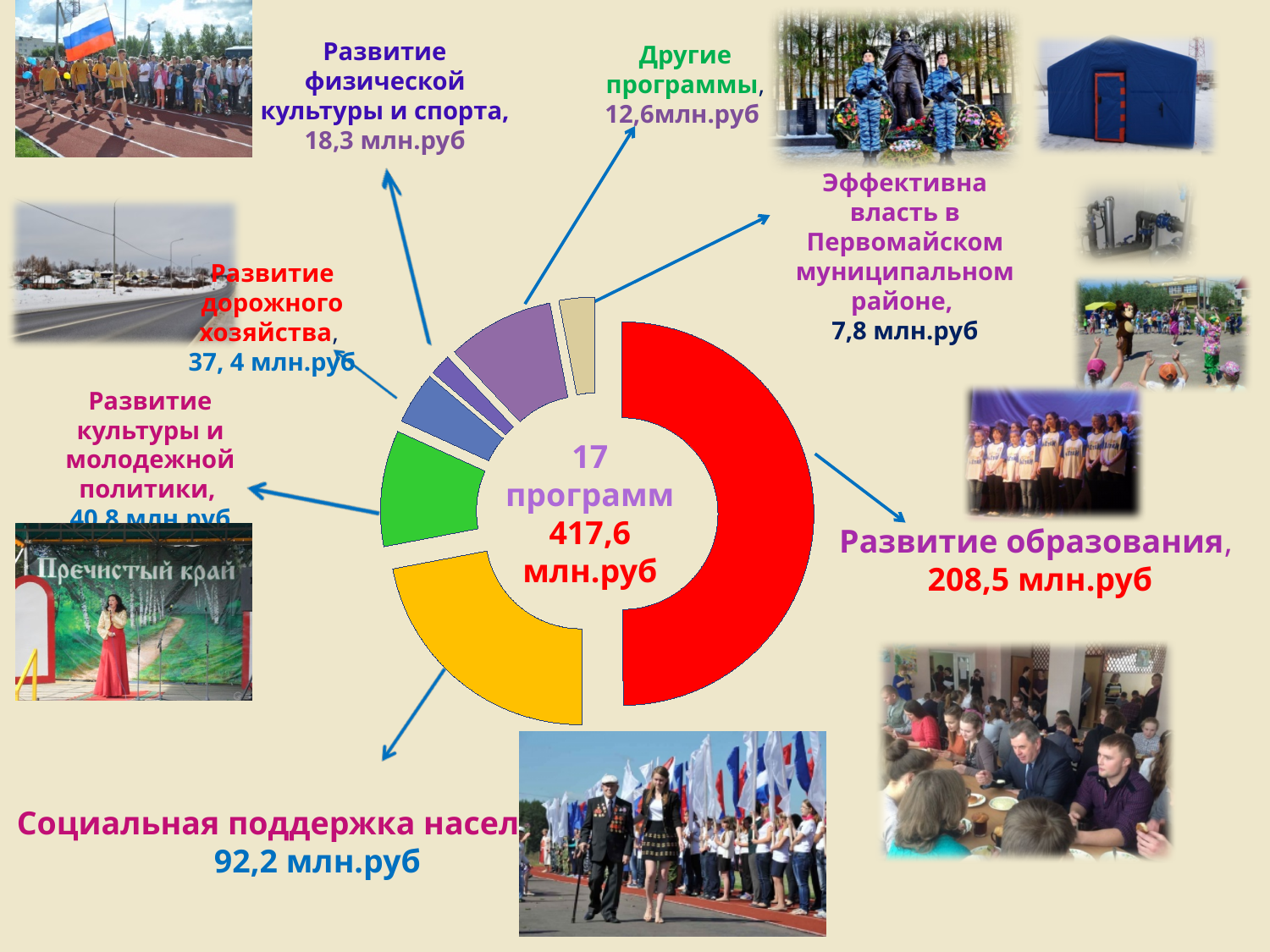
What total amount is shown in the centre of the chart? 417,6 млн.руб What is the value for Развитие образования? 208,5 млн.руб Which program has the largest value? Развитие образования What kind of chart is shown on the slide? Donut (pie) chart Which is larger: Развитие культуры и молодежной политики or Развитие дорожного хозяйства? Развитие культуры и молодежной политики What is the value for Развитие физической культуры и спорта? 18,3 млн.руб What is the difference between Развитие образования and Социальная поддержка населения? 116,3 млн.руб Which labelled program has the smallest value? Эффективная власть в Первомайском муниципальном районе What is the value for Эффективная власть в Первомайском муниципальном районе? 7,8 млн.руб What is the value for Развитие дорожного хозяйства? 37, 4 млн.руб What is the value for Социальная поддержка населения? 92,2 млн.руб What is the value for Другие программы? 12,6млн.руб